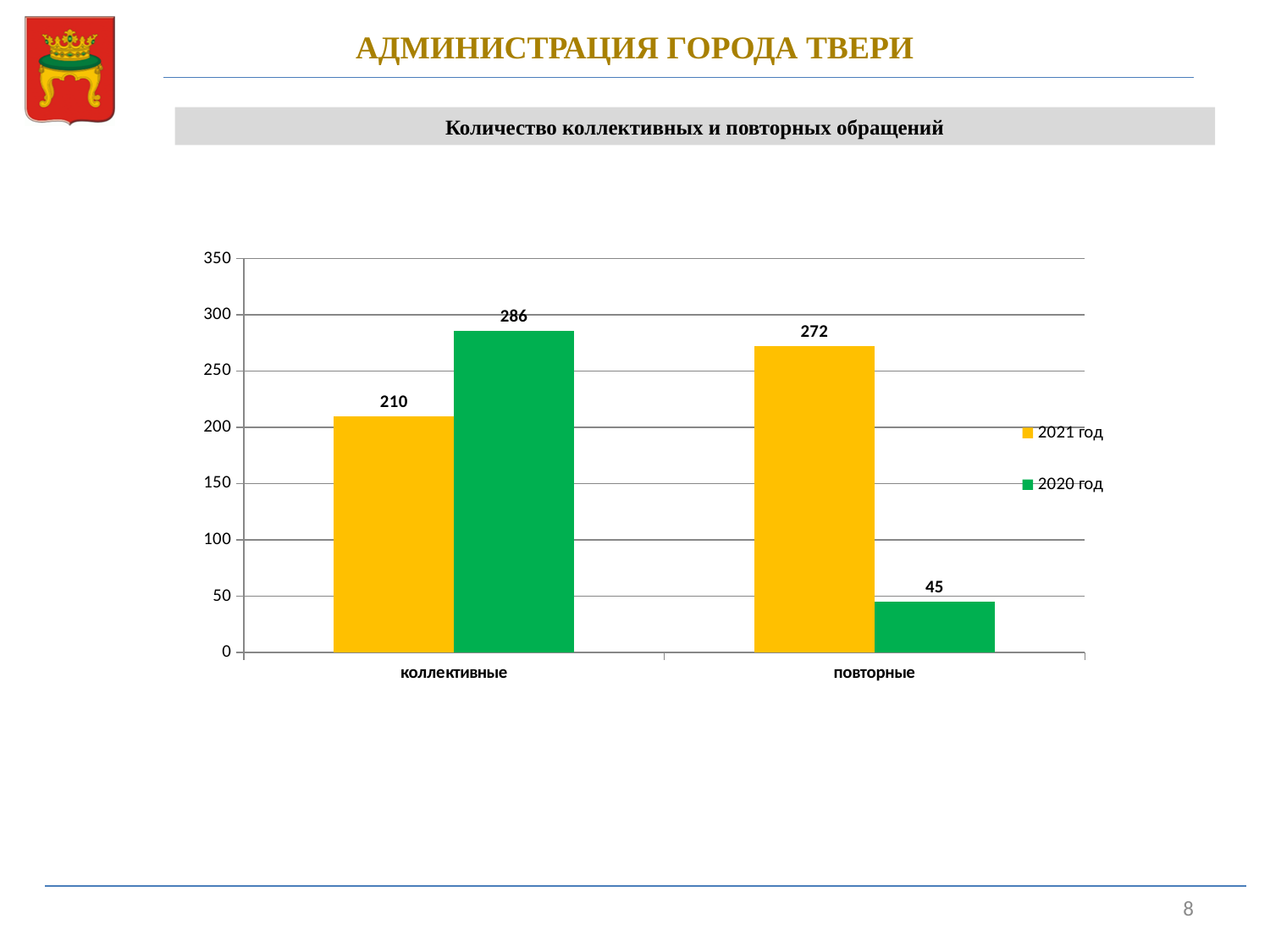
How many categories are shown on the x axis? 2 What kind of chart is shown on the slide? bar chart What is the difference between the 2020 год and 2021 год values for коллективные? 76 What is the difference between the 2021 год and 2020 год values for повторные? 227 What is the value for коллективные in 2021 год? 210 Which is larger for повторные: the 2021 год value or the 2020 год value? 2021 год What is the value for повторные in 2020 год? 45 How many series does the legend list? 2 What is the value for повторные in 2021 год? 272 Which category has the lowest value in the 2020 год series? повторные Which category has the highest value in the 2020 год series? коллективные What is the value for коллективные in 2020 год? 286